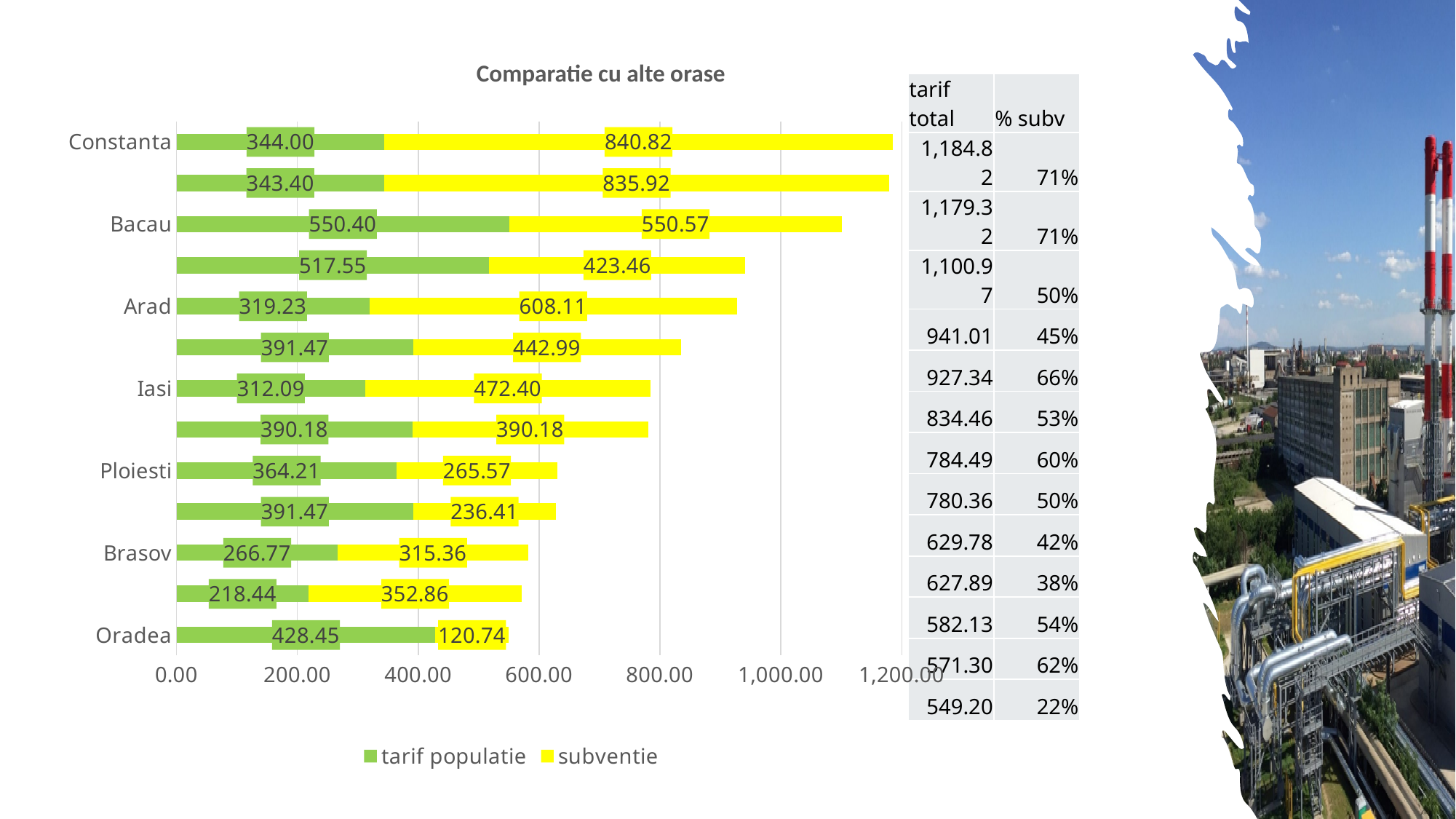
Which city has the lowest subventie value? Oradea Is the total bar length for Arad greater or less than 1,000.00? less What is the total of the stacked bar for Bacau? 1,100.97 What kind of chart is shown on the slide? Stacked bar chart Among the labeled cities, which has the highest tarif populatie? Bacau For Ploiesti, which is larger: tarif populatie or subventie? tarif populatie What is the tarif populatie value for Constanta? 344.00 How many series does the legend list? 2 What is the title of the chart? Comparatie cu alte orase What is the subventie value for Oradea? 120.74 For Constanta, how much larger is the subventie than the tarif populatie? 496.82 What is the subventie value for Arad? 608.11